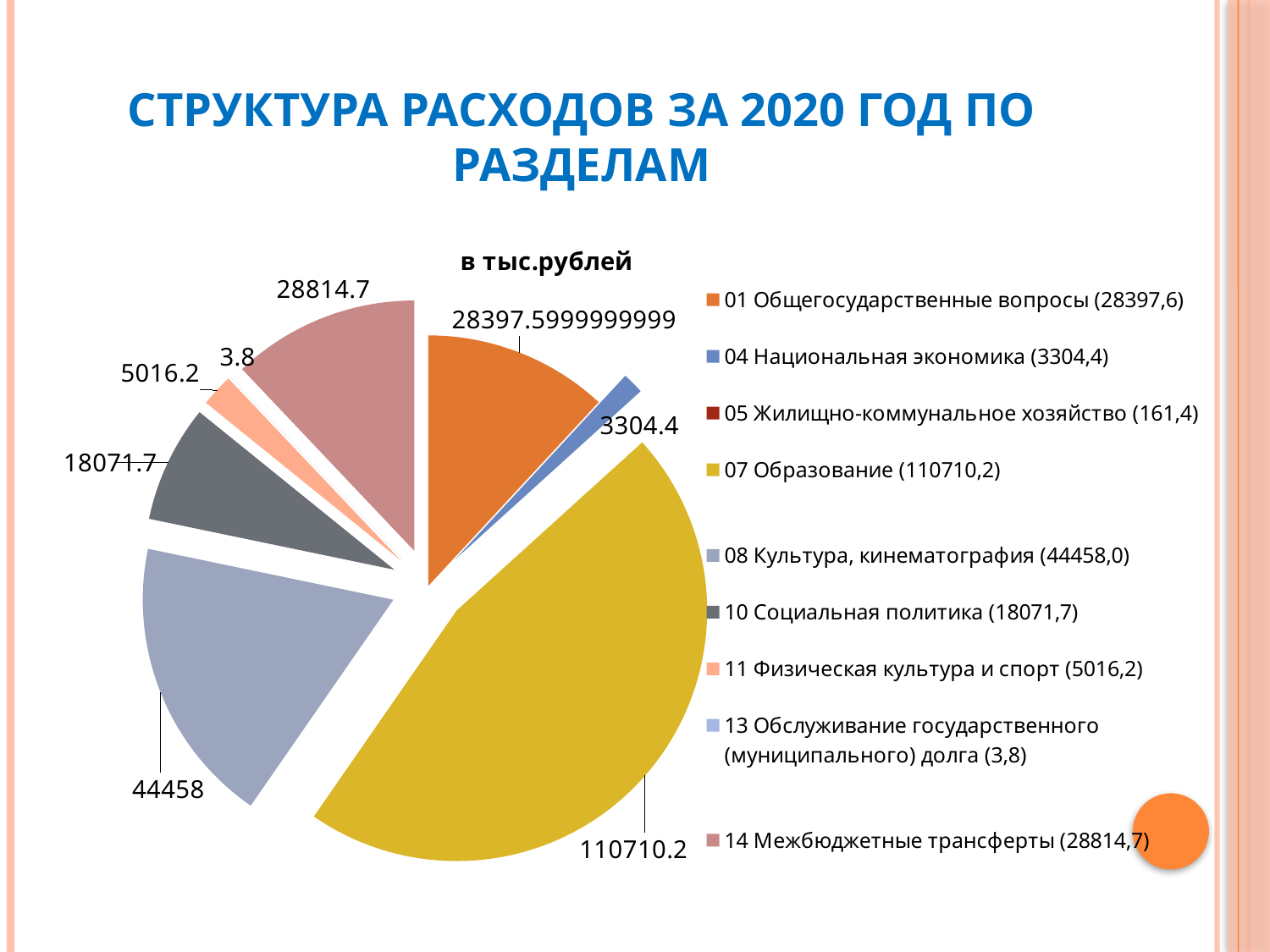
What is the value shown for 11 Физическая культура и спорт? 5016.2 What kind of chart is shown on the slide? pie chart What is the title printed above the pie chart? в тыс.рублей How many categories does the legend of the pie chart list? 9 What is the value shown for 08 Культура, кинематография? 44458 Which category has the smallest value in the pie chart? 13 Обслуживание государственного (муниципального) долга What is the value shown for 10 Социальная политика? 18071.7 What is the difference between the values for 08 Культура, кинематография and 10 Социальная политика? 26386.3 What is the value shown for 07 Образование? 110710.2 Which category has the largest slice of the pie? 07 Образование Which is larger: the value for 04 Национальная экономика or for 11 Физическая культура и спорт? 11 Физическая культура и спорт What is the value shown for 14 Межбюджетные трансферты? 28814.7